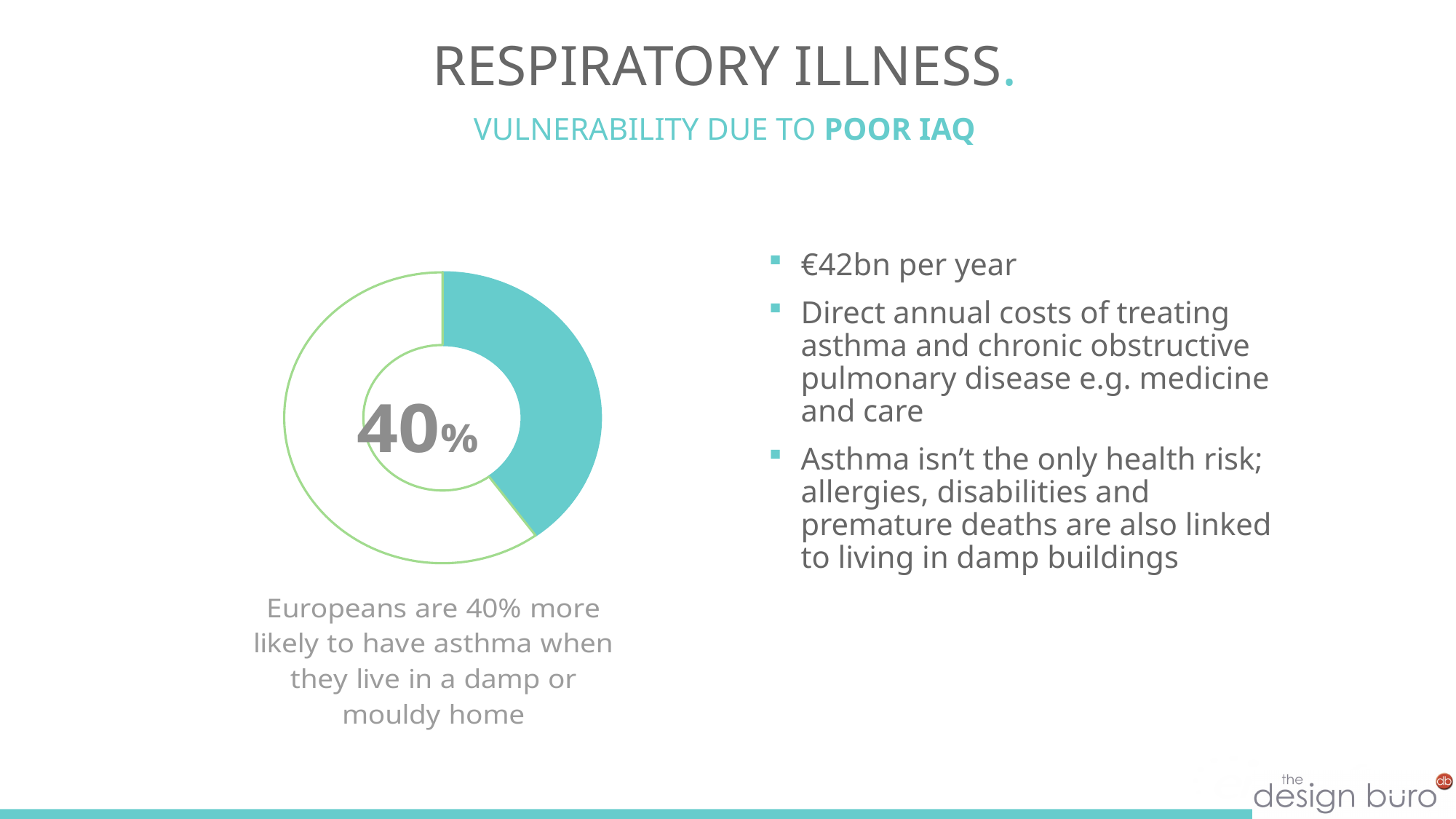
How many segments does the donut chart have? 2 What colour is the filled segment of the donut chart? Teal What kind of chart is shown on the slide? Donut chart What share of the donut chart does the teal (filled) segment represent? 40% Which segment of the donut chart is larger, the teal filled segment or the white unfilled segment? The white unfilled segment What percentage is printed in the centre of the donut chart? 40% According to the caption under the donut chart, how much more likely are Europeans to have asthma when they live in a damp or mouldy home? 40% more likely Is the teal segment of the donut chart greater or less than half of the ring? less